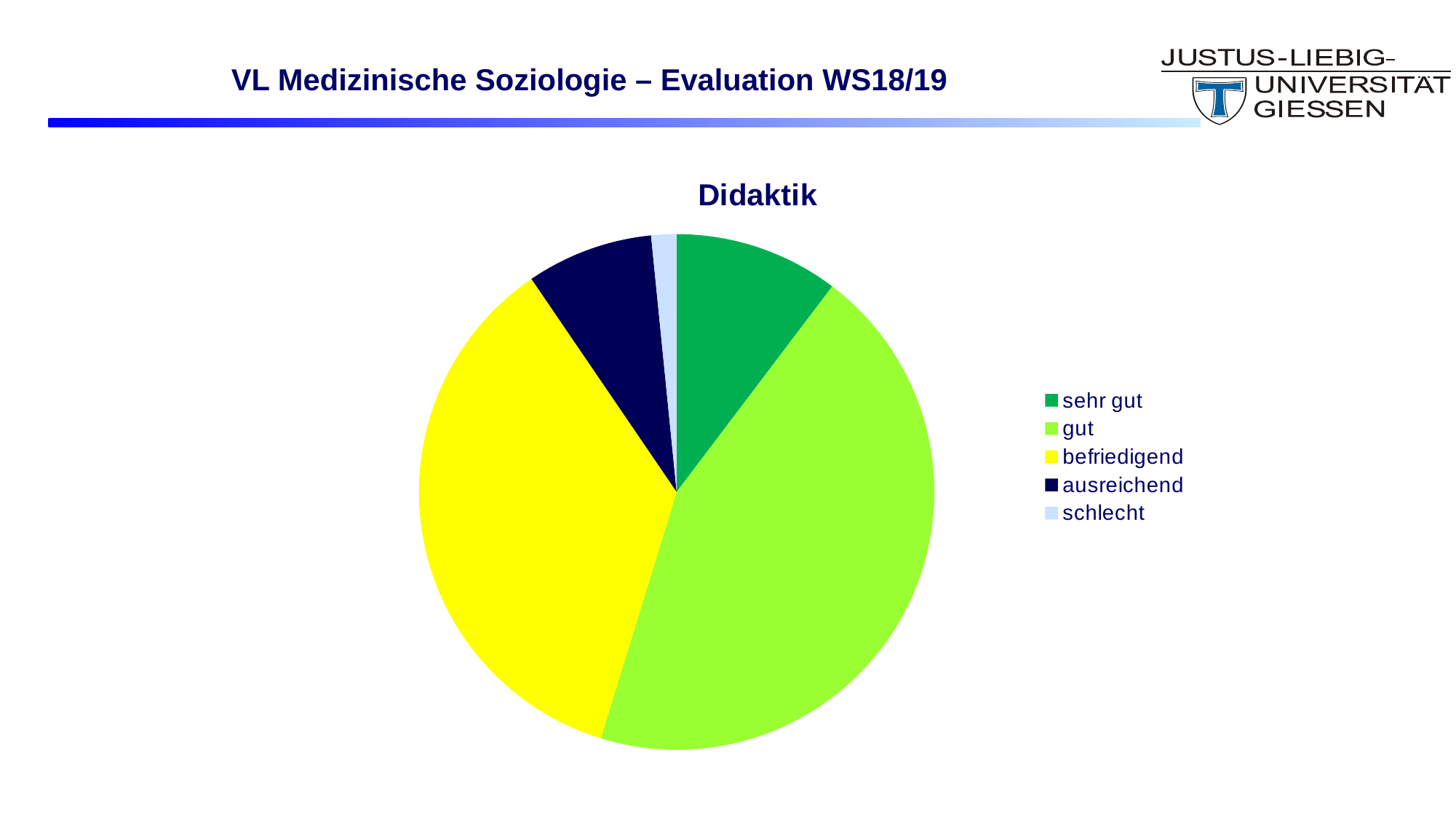
Which slice is larger, ausreichend or schlecht? ausreichend Which slice is larger, gut or befriedigend? gut Which slice is larger, sehr gut or schlecht? sehr gut Which category has the largest slice of the pie? gut What kind of chart is shown on the slide? pie chart What is the title of the chart? Didaktik Which category has the smallest slice of the pie? schlecht How many entries does the legend list? 5 Which category is shown in yellow? befriedigend How many categories does the pie chart have? 5